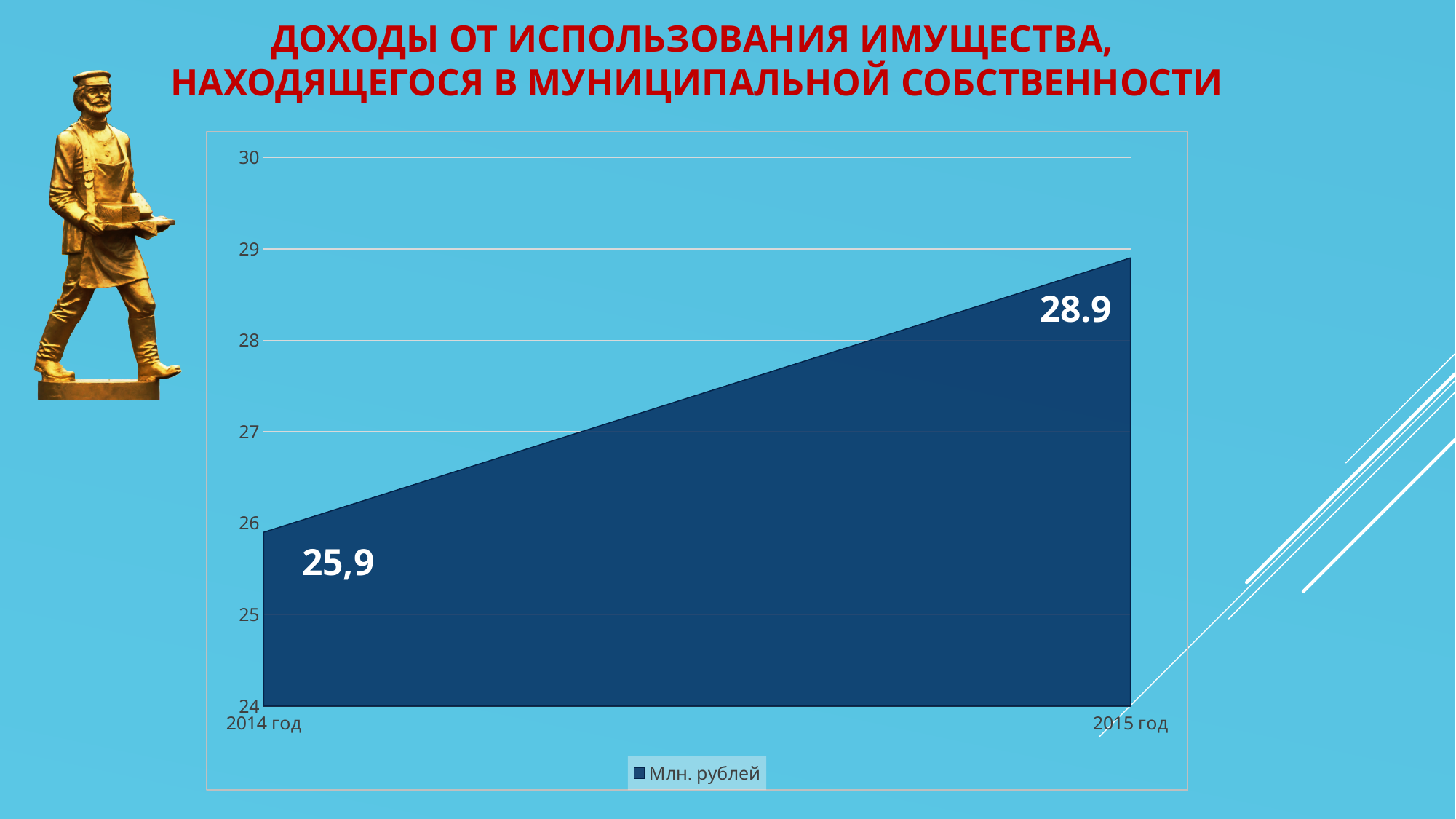
Is the value for 2014 год greater or less than 26? less Which year has the lower value? 2014 год Which year has the higher value? 2015 год Is the value for 2015 год larger or smaller than the value for 2014 год? larger What is the value for 2014 год? 25,9 How many years are plotted on the chart? 2 What is the value for 2015 год? 28.9 Is the value for 2015 год greater or less than 28? greater What kind of chart is shown on the slide? area chart What is the legend entry of the chart? Млн. рублей How many series does the legend list? 1 By how much did the value increase from 2014 год to 2015 год? 3.0